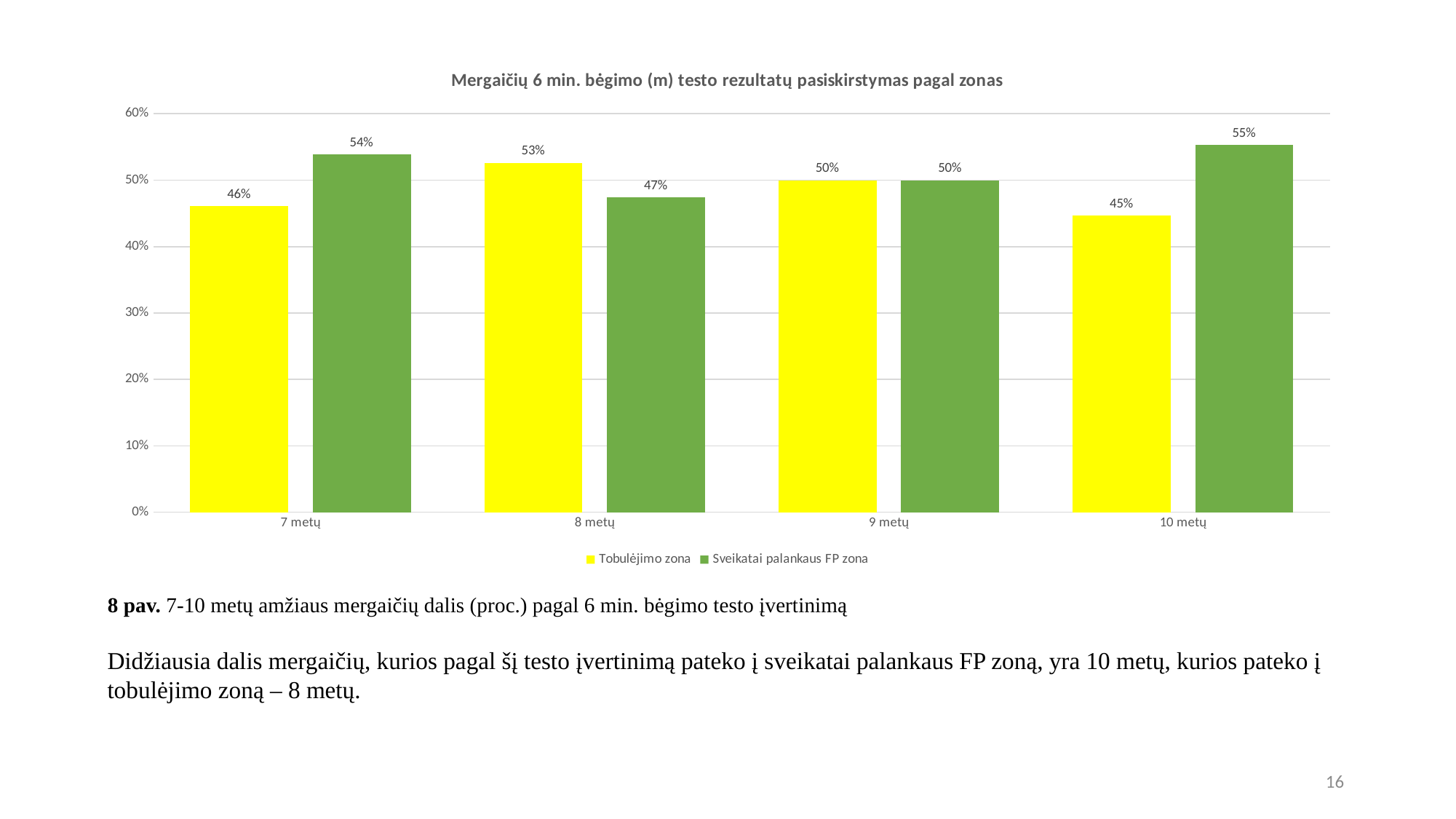
Which age group has the highest value for Tobulėjimo zona? 8 metų What is the value for Sveikatai palankaus FP zona at 8 metų? 47% What is the value for Tobulėjimo zona at 10 metų? 45% Which age group has the lowest value for Sveikatai palankaus FP zona? 8 metų What is the difference between the Sveikatai palankaus FP zona value and the Tobulėjimo zona value at 10 metų? 10% How many age groups are shown on the x axis? 4 What is the value for Tobulėjimo zona at 7 metų? 46% What colour are the bars for Sveikatai palankaus FP zona? Green At 8 metų, which series has the larger value, Tobulėjimo zona or Sveikatai palankaus FP zona? Tobulėjimo zona Is the value for Tobulėjimo zona at 9 metų greater or less than 40%? greater What kind of chart is shown on the slide? Bar chart How many series does the legend list? 2